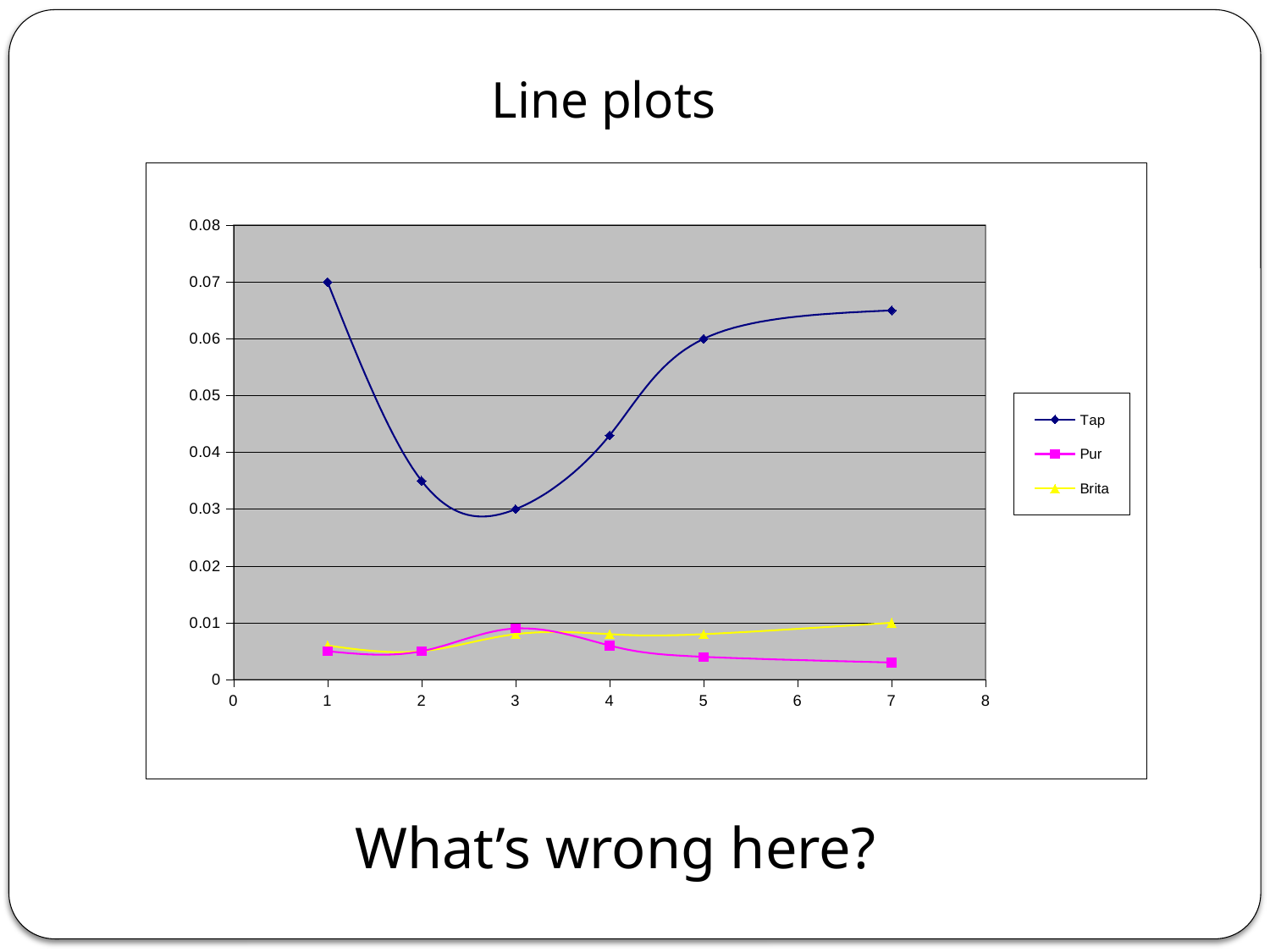
Which series are listed in the legend? Tap, Pur, Brita What is the value of the Tap series at x = 1? 0.07 How many series does the legend list? 3 At which x value does the Tap series reach its highest point? 1 Which series has the highest values across the chart? Tap What is the value of the Tap series at x = 3? 0.03 At which x value does the Tap series reach its lowest point? 3 How many data points are plotted for the Tap series? 6 Is the value of the Tap series at x = 2 greater or less than 0.04? less Is the value of the Tap series at x = 7 greater or less than 0.06? greater What kind of chart is shown on the slide? line chart What is the value of the Tap series at x = 5? 0.06